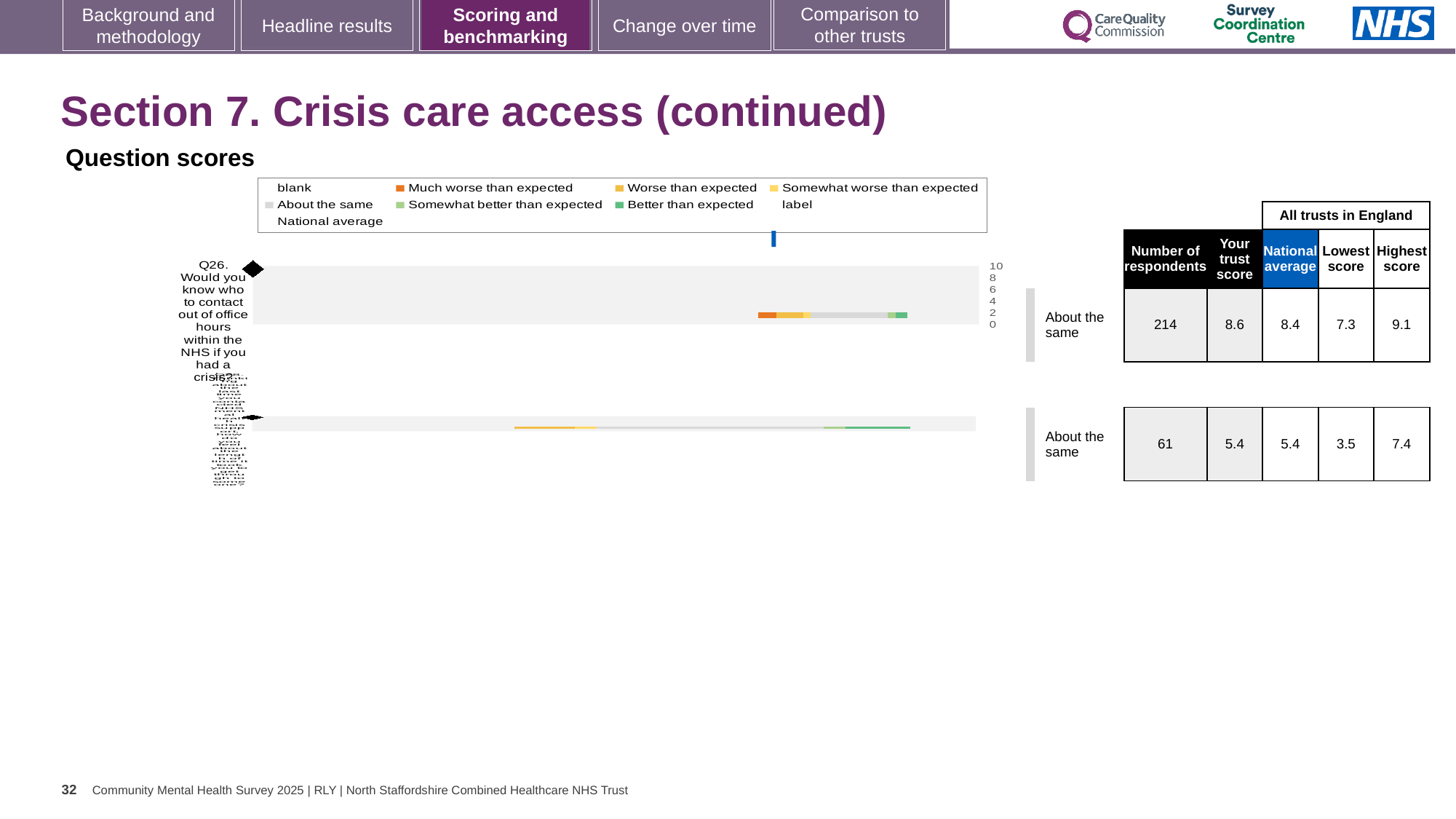
What is the highest score among all trusts in England for Q26? 9.1 What is the trust score for the second (lower) question row? 5.4 What kind of chart is shown under 'Question scores'? bar chart What is the difference between the trust score and the national average for Q26? 0.2 What is the lowest score among all trusts in England for the second (lower) question row? 3.5 What is the national average for Q26? 8.4 What is the difference between the highest and lowest scores in England for the second (lower) question row? 3.9 What benchmark category is shown for Q26? About the same What is the trust score for Q26? 8.6 How many question rows are plotted in the chart? 2 Which is larger for Q26, the trust score or the national average? the trust score What is the number of respondents for Q26 (Would you know who to contact out of office hours within the NHS if you had a crisis?)? 214